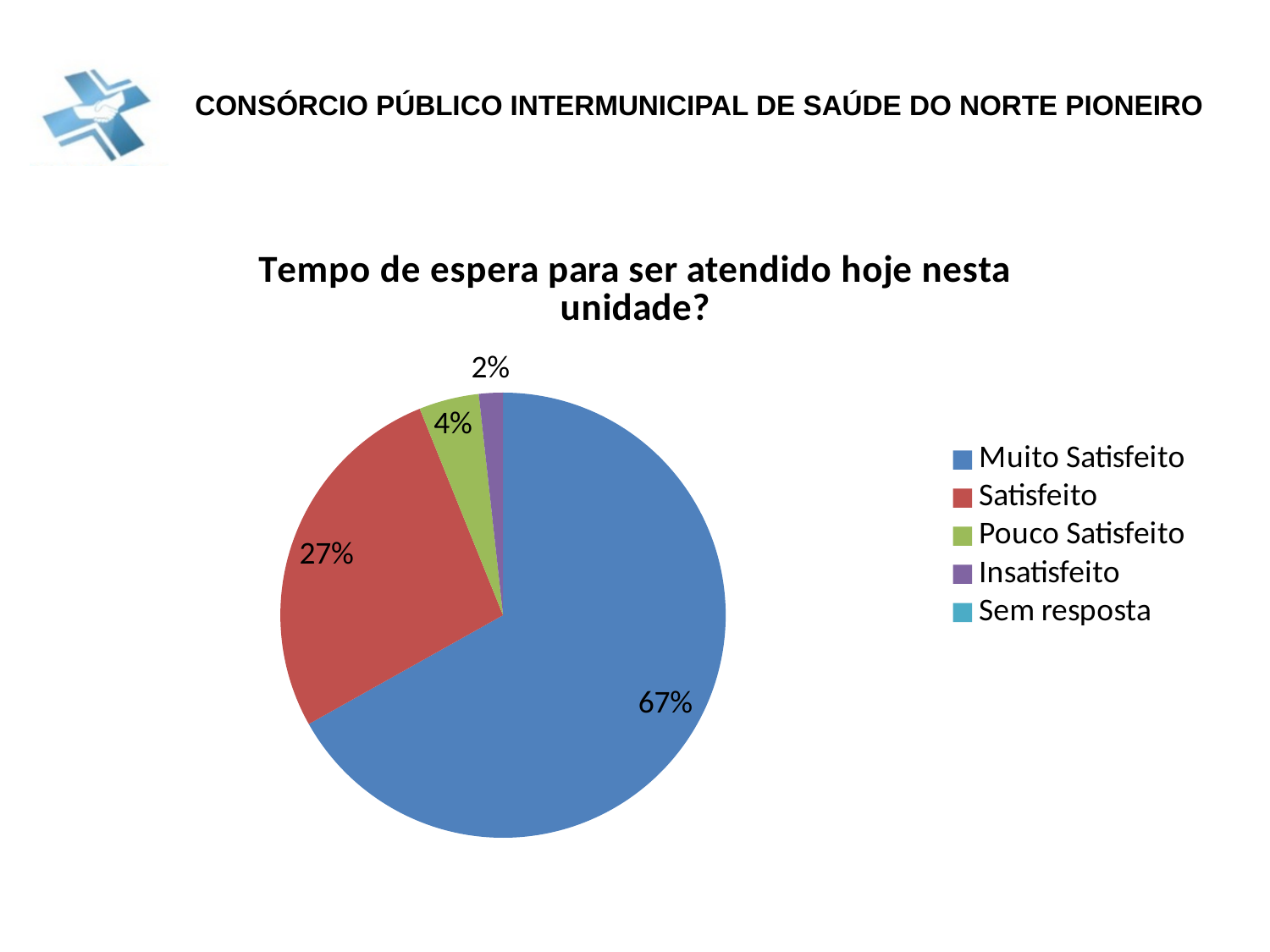
What kind of chart is shown on the slide? Pie chart What share of the pie does Satisfeito represent? 27% Which is larger, Satisfeito or Pouco Satisfeito? Satisfeito Which of the labelled slices is the smallest? Insatisfeito What share of the pie does Insatisfeito represent? 2% What share of the pie does Pouco Satisfeito represent? 4% What colour is the Satisfeito slice? Red What is the title of the chart? Tempo de espera para ser atendido hoje nesta unidade? Which category has the largest slice of the pie? Muito Satisfeito What is the difference in percentage points between Muito Satisfeito and Satisfeito? 40 How many categories does the legend list? 5